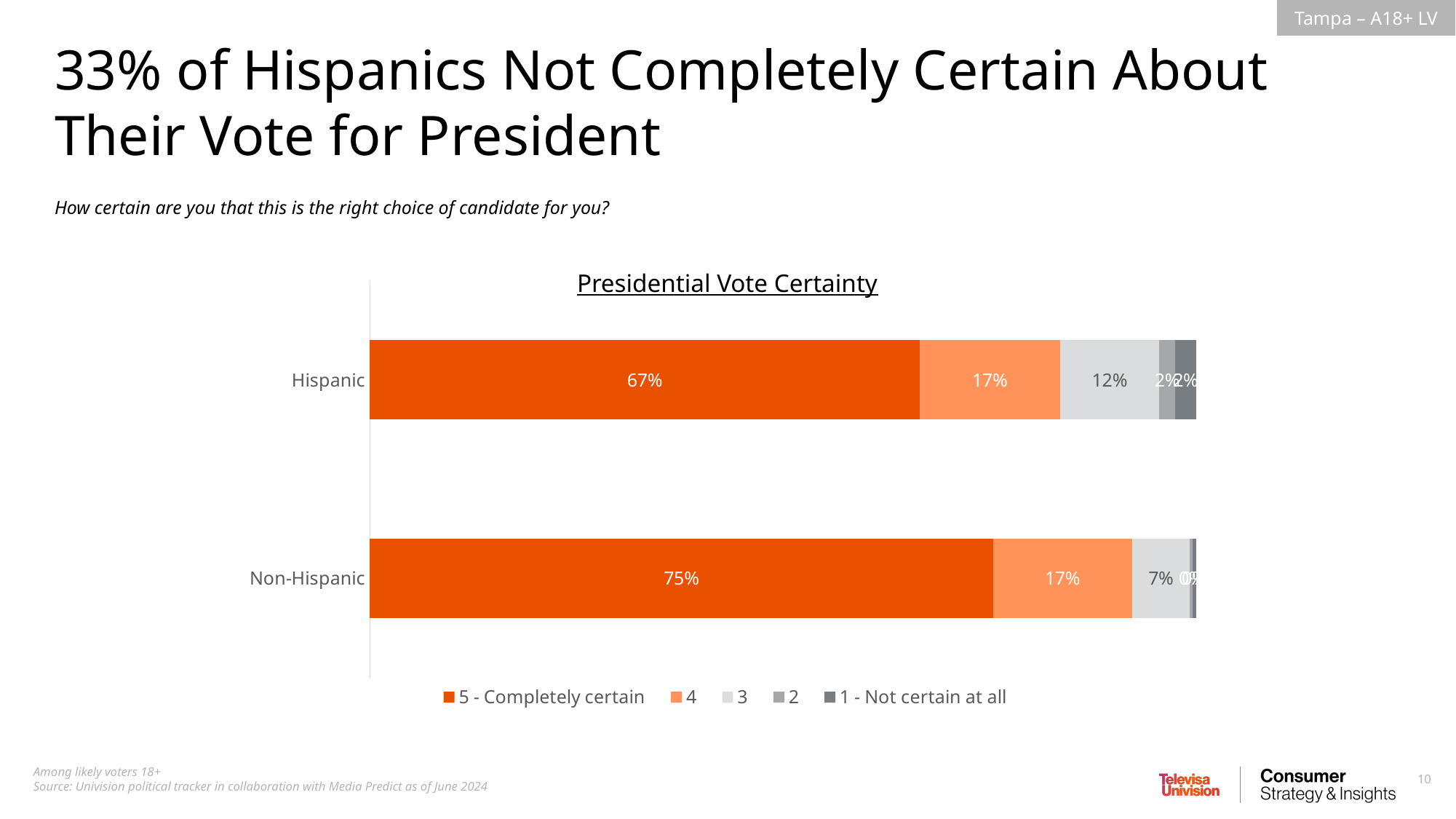
Which group has the higher share of "5 - Completely certain" voters, Hispanic or Non-Hispanic? Non-Hispanic How many series does the legend list? 5 What is the difference in percentage points between the "5 - Completely certain" shares for Non-Hispanic and Hispanic voters? 8 What is the value of the "3" segment for Hispanic voters? 12% How many groups (categories) are shown in the chart? 2 What percentage of Hispanic likely voters are "5 - Completely certain" about their presidential vote? 67% What percentage of Non-Hispanic likely voters are "5 - Completely certain" about their presidential vote? 75% What is the title of the chart? Presidential Vote Certainty What is the value of the "3" segment for Non-Hispanic voters? 7% What type of chart is shown on the slide? Stacked bar chart What is the value of the "4" segment for Non-Hispanic voters? 17% What is the difference in percentage points between the "3" segments for Hispanic and Non-Hispanic voters? 5